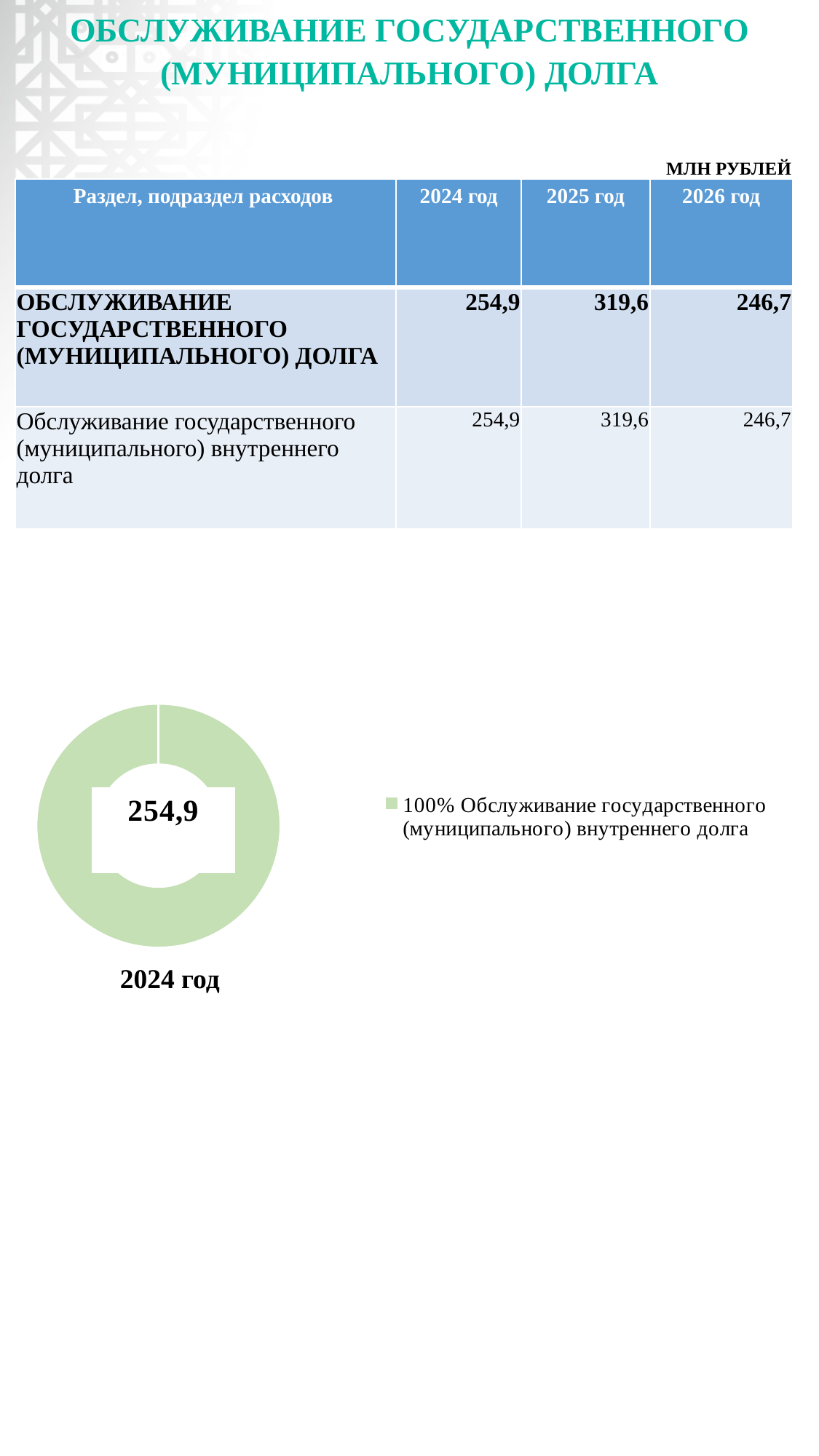
What colour is the slice of the doughnut chart? green What value is printed in the centre of the doughnut chart? 254,9 Is the value shown in the centre of the doughnut chart greater or less than 200? greater What kind of chart is shown on the slide? doughnut chart How many entries does the legend of the doughnut chart list? 1 What share of the doughnut chart does "Обслуживание государственного (муниципального) внутреннего долга" take? 100% Which year is the doughnut chart labelled with? 2024 год How many slices does the doughnut chart have? 1